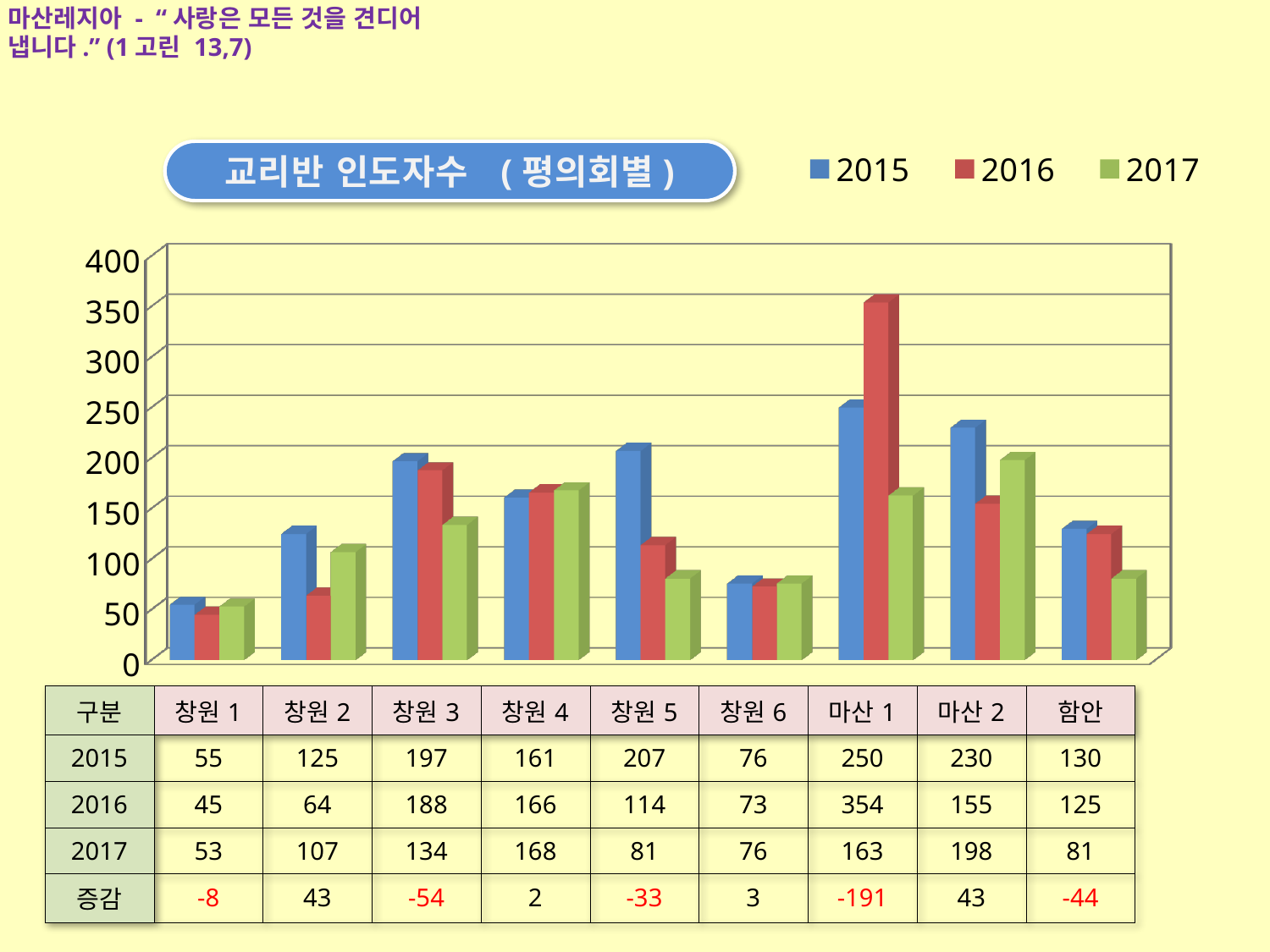
How many series does the legend list? 3 What is the 2015 value for 창원 5? 207 What is the title of the chart? 교리반 인도자수 (평의회별) How many categories are shown along the x axis of the chart? 9 Which category has the lowest 2015 value? 창원 1 Which is larger for 창원 2: the 2015 value or the 2017 value? 2015 What is the 2016 value for 마산 1? 354 Which category has the highest 2016 value? 마산 1 Is the 2015 value for 마산 2 greater or less than 200? greater What is the 2017 value for 마산 2? 198 What is the difference between the 2016 and 2017 values for 마산 1? 191 What type of chart is shown on the slide? bar chart